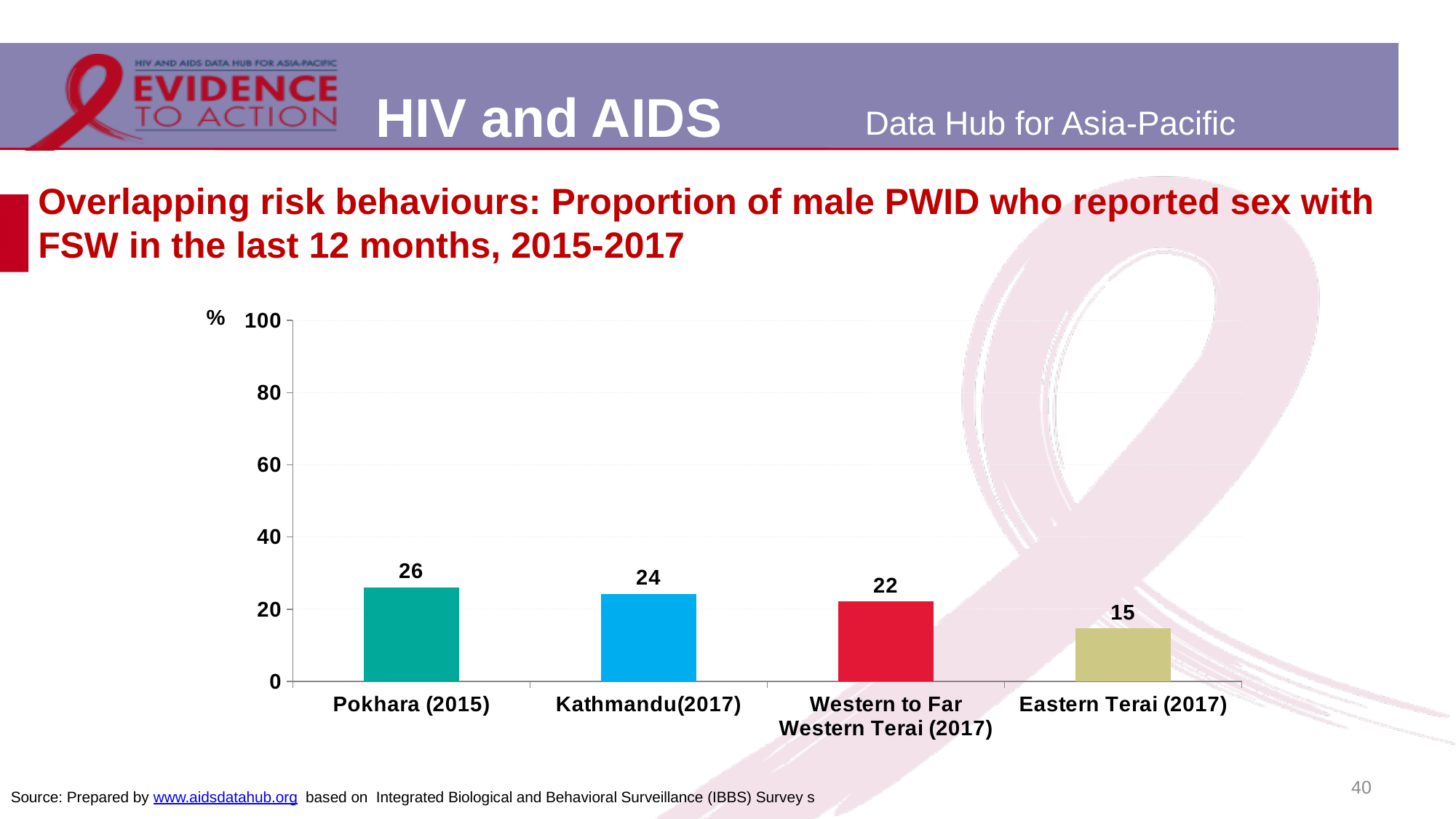
What is the value for Kathmandu(2017)? 24 What is the difference between the values for Pokhara (2015) and Eastern Terai (2017)? 11 Which category has the highest value? Pokhara (2015) What is the value for Pokhara (2015)? 26 Do the values rise or fall from left to right across the categories? fall Is the value for Western to Far Western Terai (2017) greater or less than 40? less What is the value for Eastern Terai (2017)? 15 How many categories are shown on the chart? 4 Which is larger, the value for Kathmandu(2017) or the value for Eastern Terai (2017)? Kathmandu(2017) What kind of chart is shown on the slide? bar chart What is the value for Western to Far Western Terai (2017)? 22 Which category has the lowest value? Eastern Terai (2017)